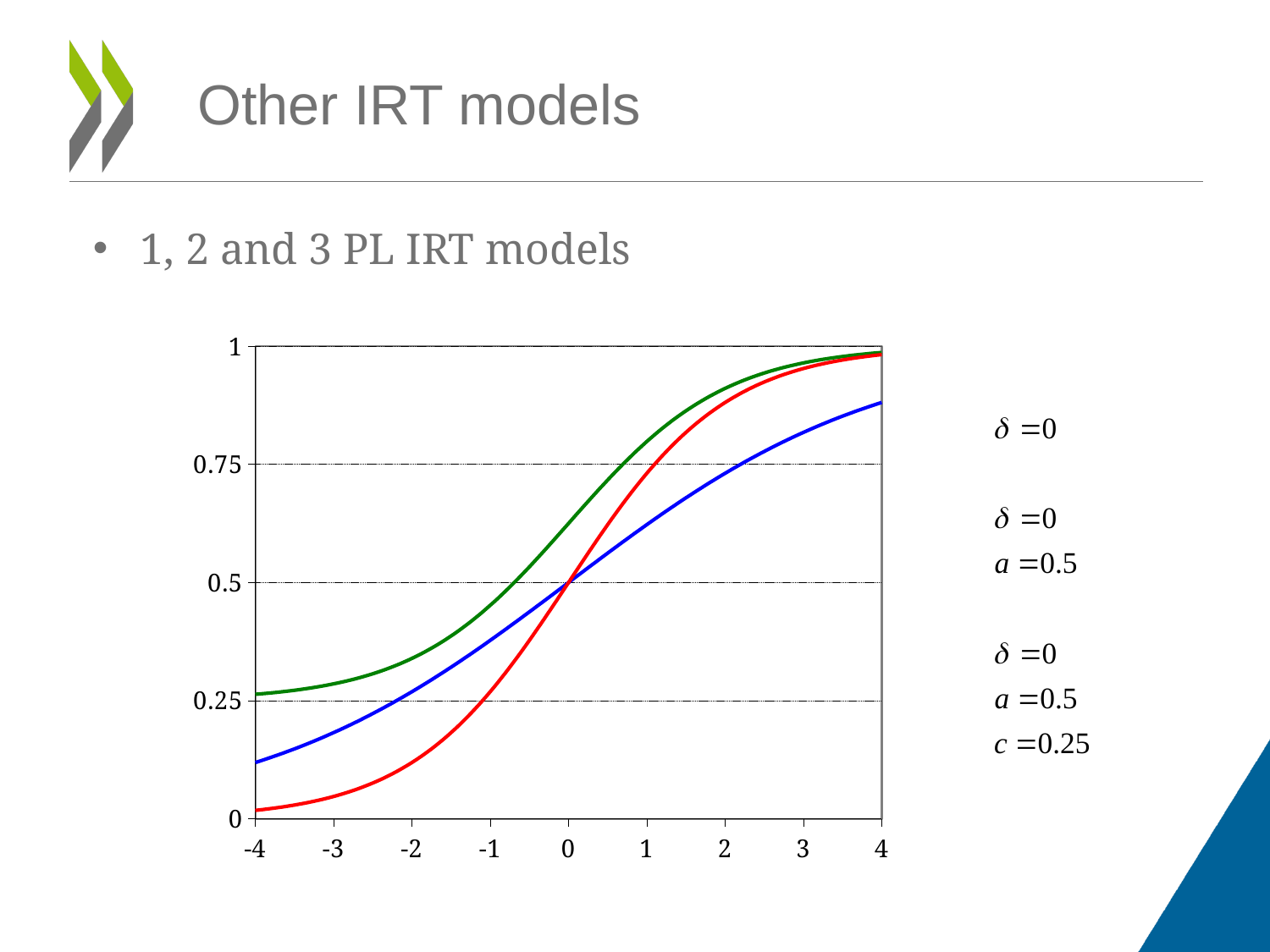
Is the value of the red curve at x = -4 greater or less than 0.25? less Is the value of the green curve at x = -4 greater or less than 0.25? greater Is the value of the blue curve at x = 4 greater or less than 0.75? greater What kind of chart is shown on the slide? line chart What is the value of the red curve at x = 0? 0.5 Do the curves rise or fall as the x axis goes from -4 to 4? rise What is the range of the x axis on the chart? -4 to 4 At x = 4, which curve has the lowest value? the blue curve At x = -4, which curve has the highest value? the green curve At x = -2, which curve is higher, the green one or the red one? the green curve At x = -4, which curve has the lowest value? the red curve How many curves are plotted on the chart? 3